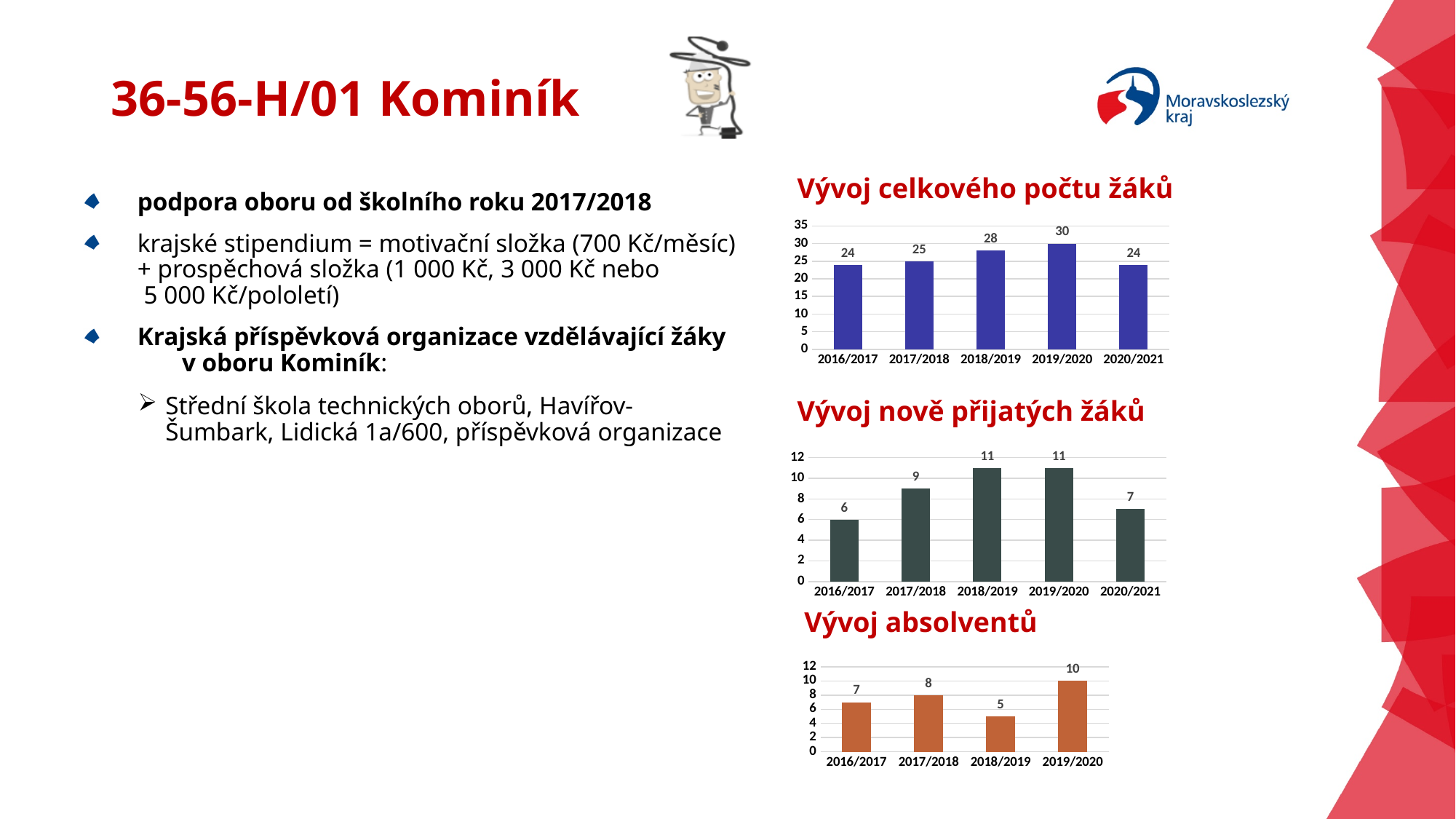
In the chart 'Vývoj absolventů', what is the difference between the values for 2019/2020 and 2018/2019? 5 In the chart 'Vývoj nově přijatých žáků', is the value for 2019/2020 larger than the value for 2020/2021? Yes In the chart 'Vývoj celkového počtu žáků', which year has the highest value? 2019/2020 In the chart 'Vývoj absolventů', what is the value for 2018/2019? 5 In the chart 'Vývoj celkového počtu žáků', what is the difference between the values for 2019/2020 and 2016/2017? 6 In the chart 'Vývoj nově přijatých žáků', which year has the lowest value? 2016/2017 In the chart 'Vývoj absolventů', which year has the highest value? 2019/2020 What type of chart is 'Vývoj absolventů'? Bar chart How many categories are shown in the chart 'Vývoj celkového počtu žáků'? 5 How many categories are shown in the chart 'Vývoj absolventů'? 4 In the chart 'Vývoj celkového počtu žáků', what is the value for 2019/2020? 30 In the chart 'Vývoj nově přijatých žáků', what is the value for 2017/2018? 9